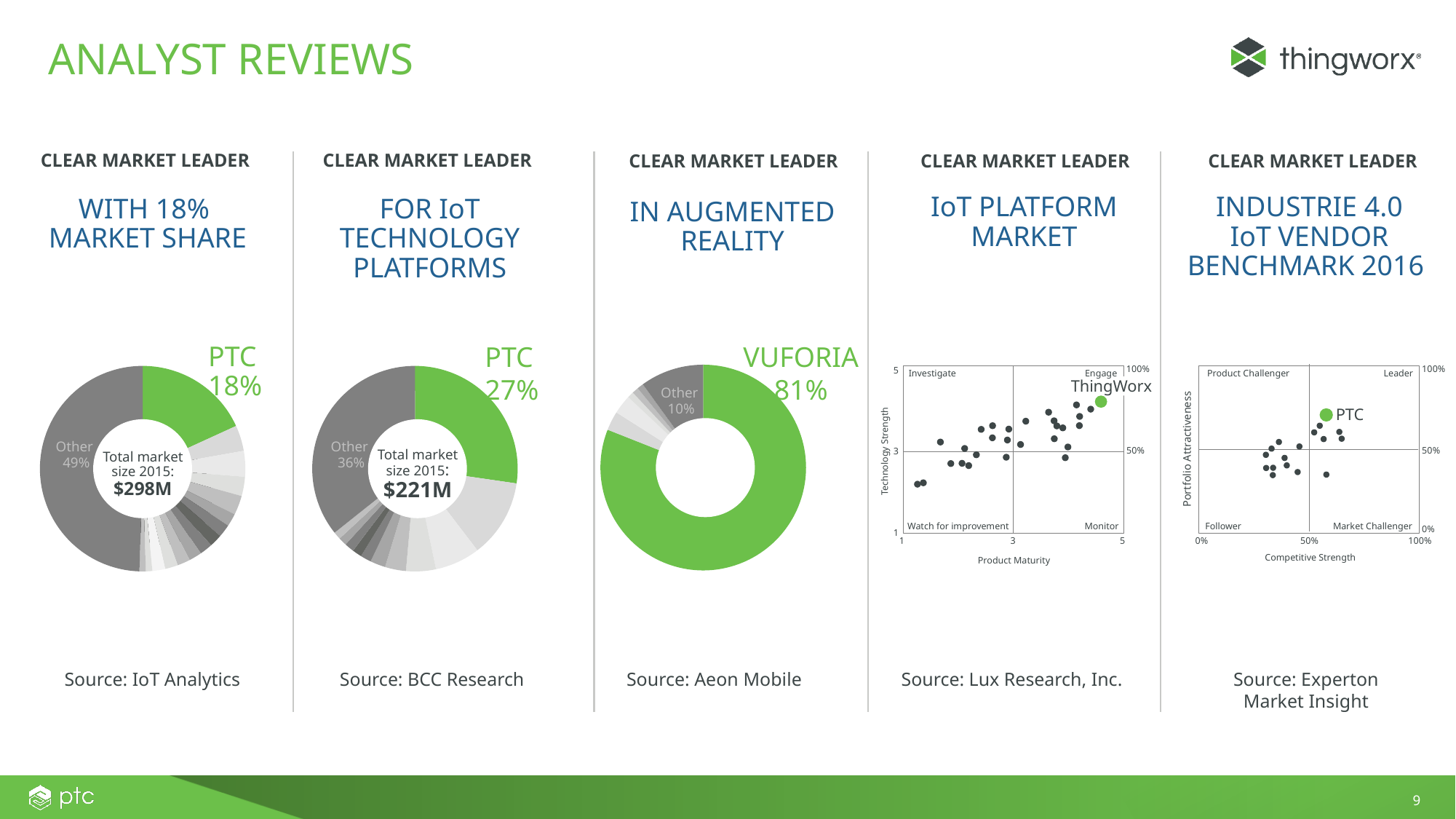
In the 'WITH 18% MARKET SHARE' donut chart, what share is shown for PTC? 18% In the 'IN AUGMENTED REALITY' donut chart, by how many percentage points does Vuforia's share exceed the Other share? 71 percentage points In the 'WITH 18% MARKET SHARE' donut chart, what is the total market size for 2015 shown in the centre? $298M In the 'IN AUGMENTED REALITY' donut chart, what share is shown for Other? 10% In the 'IN AUGMENTED REALITY' donut chart, what share is shown for Vuforia? 81% What kind of chart is shown under 'IoT PLATFORM MARKET'? Scatter plot In the 'FOR IoT TECHNOLOGY PLATFORMS' donut chart, what is the total market size for 2015 shown in the centre? $221M In the 'WITH 18% MARKET SHARE' donut chart, what share is shown for Other? 49% In the 'IoT PLATFORM MARKET' scatter plot, is the Product Maturity value for ThingWorx greater or less than 3? greater In the 'WITH 18% MARKET SHARE' donut chart, which is larger, the PTC share or the Other share? Other In the 'FOR IoT TECHNOLOGY PLATFORMS' donut chart, what share is shown for PTC? 27% In the 'INDUSTRIE 4.0 IoT VENDOR BENCHMARK 2016' scatter plot, which quadrant is PTC plotted in? Leader